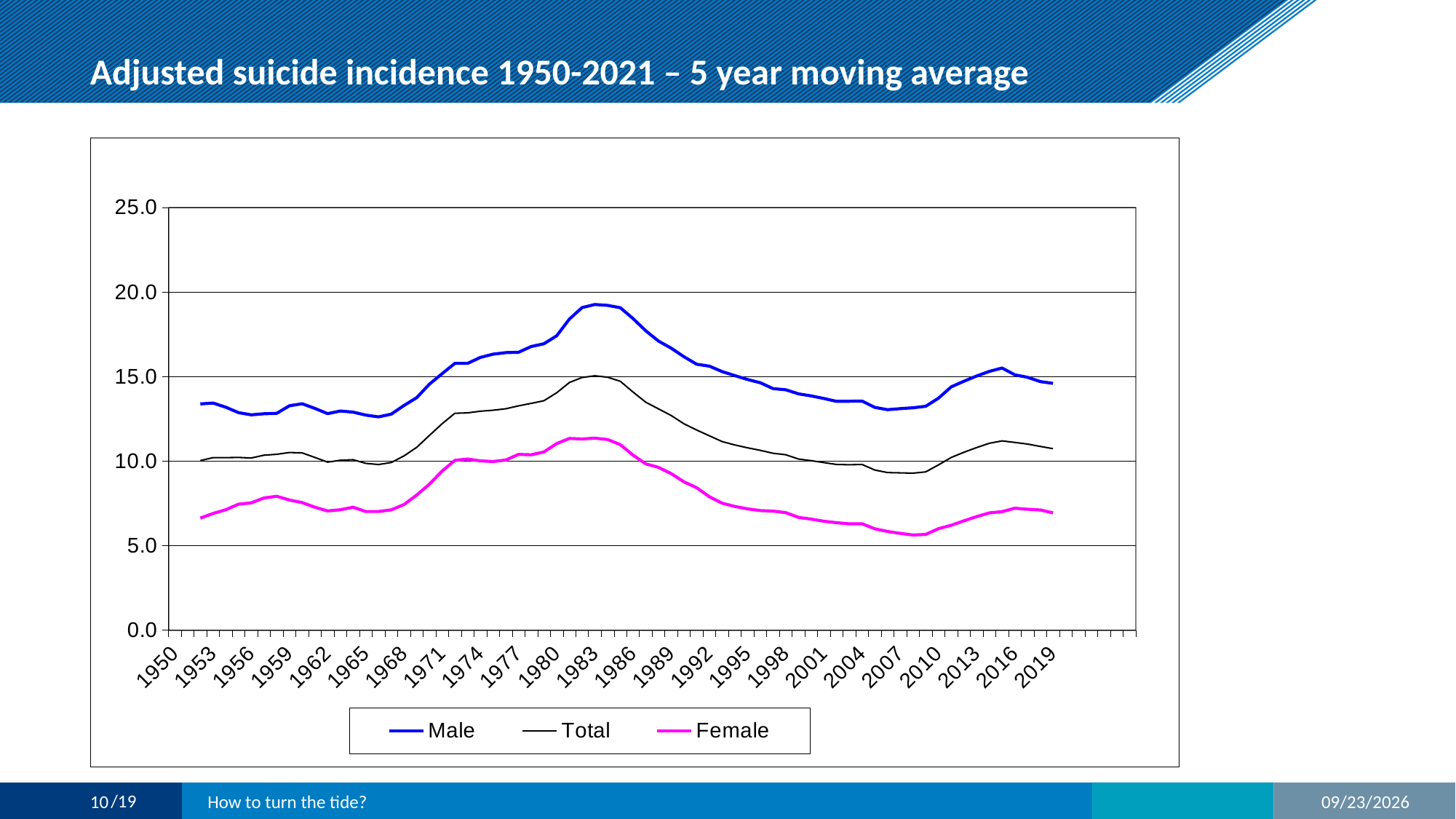
What are the three series named in the legend? Male, Total, Female Is the value for Female in 1953 greater or less than 10.0? less Which series has the highest values across the whole period? Male What is the title of the chart? Adjusted suicide incidence 1950-2021 – 5 year moving average Is the value for Female in 1983 greater or less than 10.0? greater Does the Male series rise or fall between 1983 and 2007? fall Which is larger in 1983, the Male value or the Female value? Male Is the value for Total in 2007 greater or less than 10.0? less How many series does the legend list? 3 What kind of chart is shown on the slide? line chart